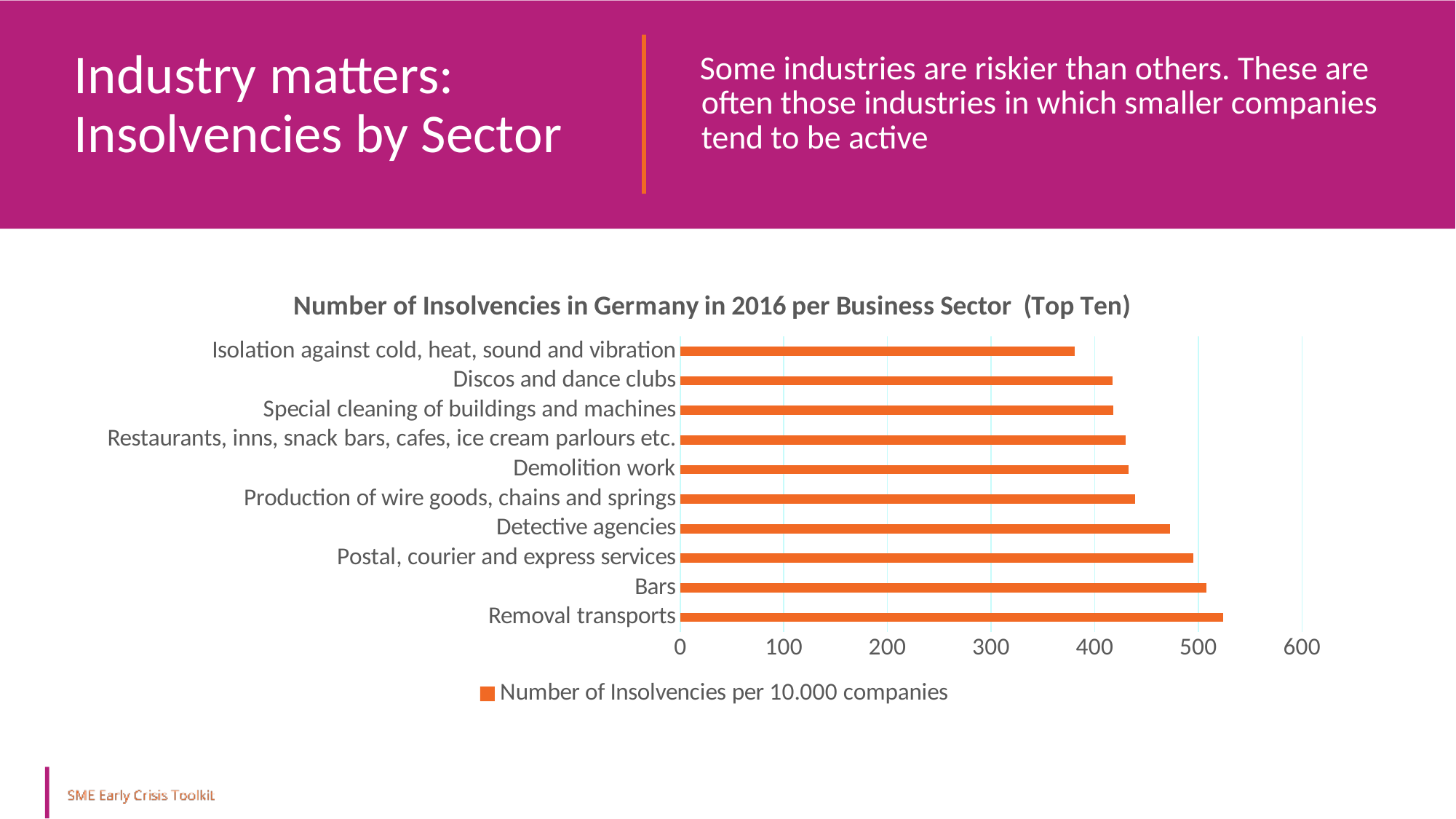
Is the value for Removal transports greater or less than 500? greater Is the value for Isolation against cold, heat, sound and vibration greater or less than 400? less What is the title of the chart? Number of Insolvencies in Germany in 2016 per Business Sector (Top Ten) Which sector has the lowest number of insolvencies per 10.000 companies? Isolation against cold, heat, sound and vibration What kind of chart is shown on the slide? bar chart Is the value for Discos and dance clubs greater or less than 400? greater What is the legend entry of the chart? Number of Insolvencies per 10.000 companies Which has more insolvencies per 10.000 companies, Detective agencies or Demolition work? Detective agencies How many series does the chart legend list? 1 Which sector has the highest number of insolvencies per 10.000 companies? Removal transports How many business sectors are shown in the chart? 10